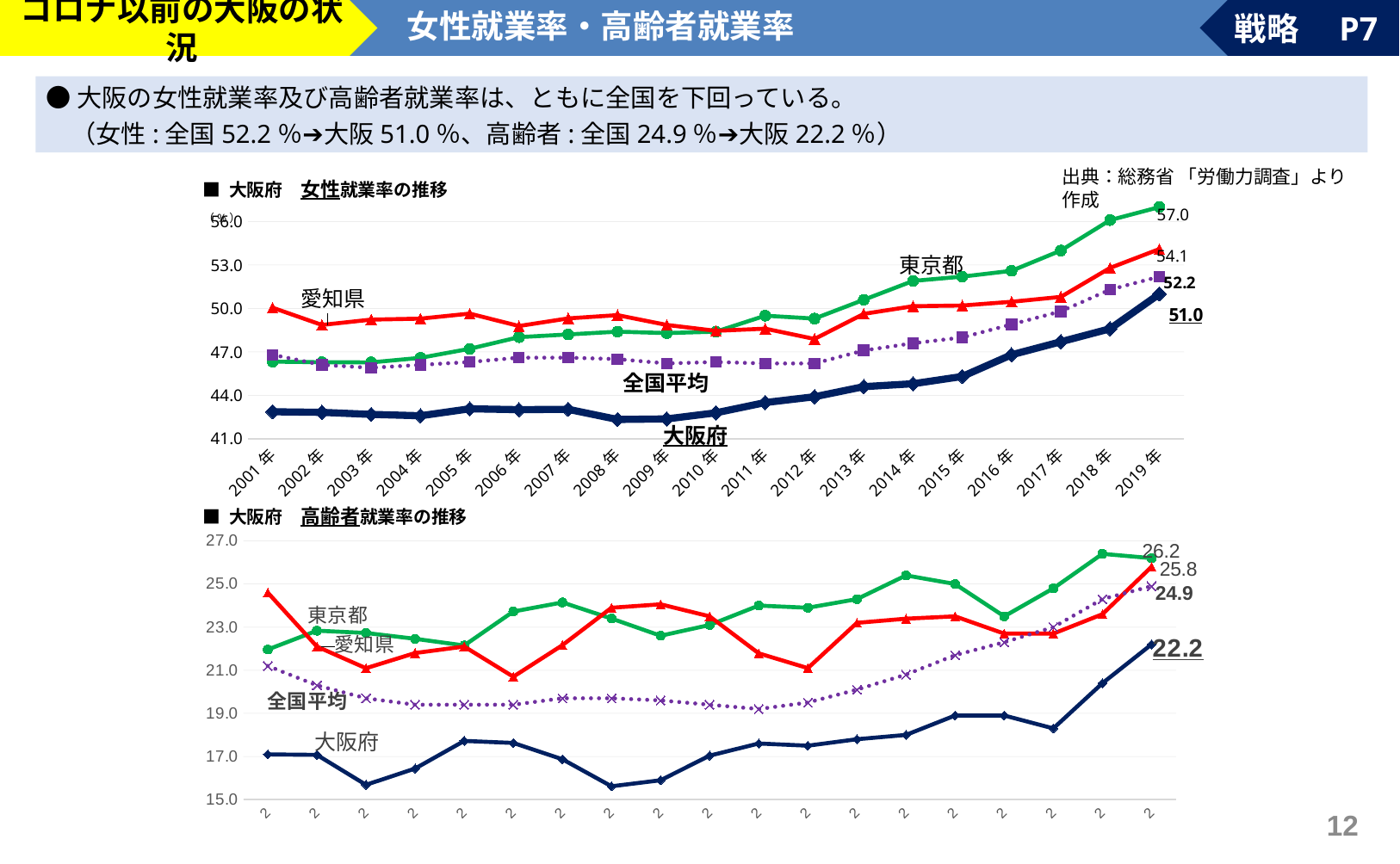
In the top chart (大阪府 女性就業率の推移), what is the value for 東京都 in 2019年? 57.0 In the bottom chart (大阪府 高齢者就業率の推移), which series has the lowest value at the last point? 大阪府 In the bottom chart (大阪府 高齢者就業率の推移), what is the value for 全国平均 at the last point? 24.9 In the top chart (大阪府 女性就業率の推移), what is the difference between 全国平均 and 大阪府 in 2019年? 1.2 What kind of chart is the top chart (大阪府 女性就業率の推移)? line chart In the bottom chart (大阪府 高齢者就業率の推移), what is the value for 大阪府 at the last point? 22.2 In the top chart (大阪府 女性就業率の推移), does the 大阪府 line rise or fall overall from 2001年 to 2019年? rise In the top chart (大阪府 女性就業率の推移), is the value for 大阪府 in 2001年 greater or less than 44.0? less In the bottom chart (大阪府 高齢者就業率の推移), what is the difference between 東京都 and 大阪府 at the last point? 4.0 In the top chart (大阪府 女性就業率の推移), which series has the highest value in 2019年? 東京都 In the top chart (大阪府 女性就業率の推移), how many years are shown on the x axis? 19 In the top chart (大阪府 女性就業率の推移), what is the value for 大阪府 in 2019年? 51.0